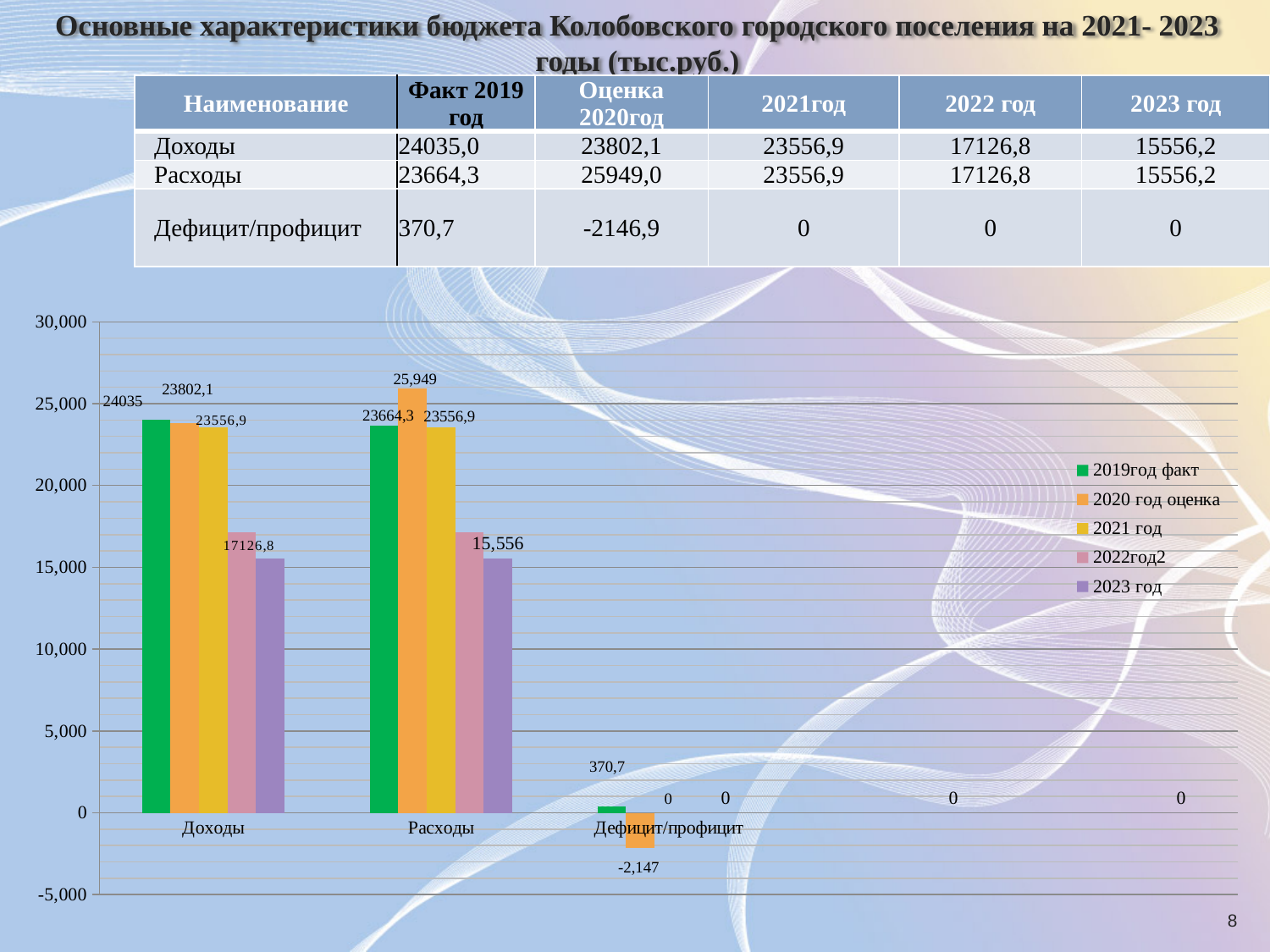
Which is larger for the 2019год факт series: Доходы or Расходы? Доходы What is the value of Расходы for the 2020 год оценка series? 25,949 What is the value of Дефицит/профицит for the 2020 год оценка series? -2,147 How many categories are shown on the x axis of the chart? 3 How many series does the chart legend list? 5 What is the difference between Доходы for 2019год факт and Доходы for 2020 год оценка? 232,9 Is the value of Доходы for the 2023 год series greater or less than 20,000? less What kind of chart is shown on the slide? bar chart What is the value of Расходы for the 2023 год series? 15,556 What is the value of Доходы for the 2019год факт series? 24035 What is the value of Дефицит/профицит for the 2019год факт series? 370,7 Which series has the highest value for Расходы? 2020 год оценка